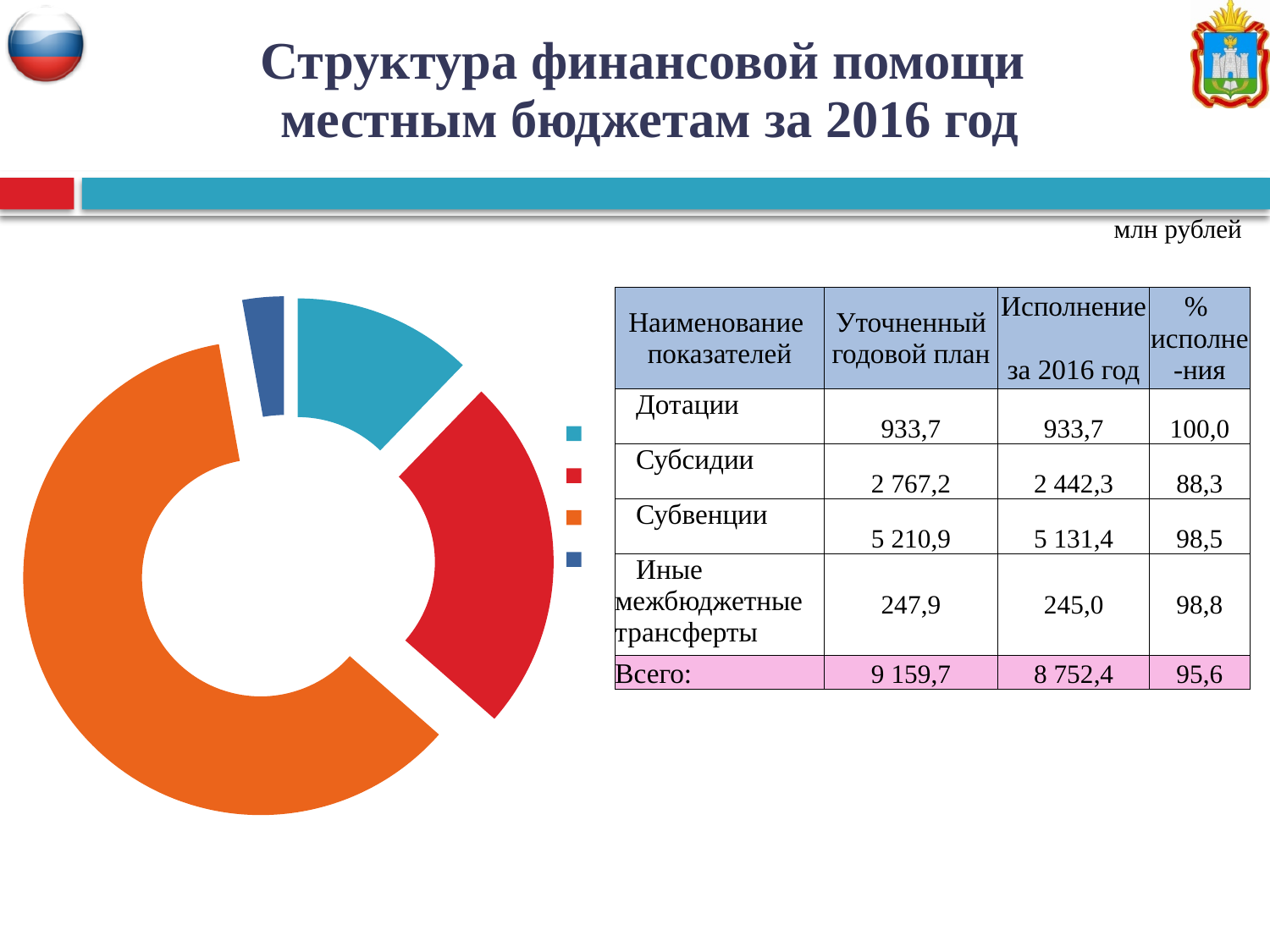
Does the orange slice take up more or less than half of the doughnut chart? more How many entries does the legend next to the doughnut chart list? 4 Which colour slice is the smallest in the doughnut chart? dark blue What colours are used for the four slices of the doughnut chart? teal, red, orange, dark blue In the doughnut chart, which slice is larger, the teal one or the dark blue one? teal In the doughnut chart, which slice is larger, the red one or the teal one? red What kind of chart is shown on the left of the slide? doughnut (pie) chart In the doughnut chart, which slice is larger, the orange one or the red one? orange Which colour slice is the largest in the doughnut chart? orange How many slices does the doughnut chart have? 4